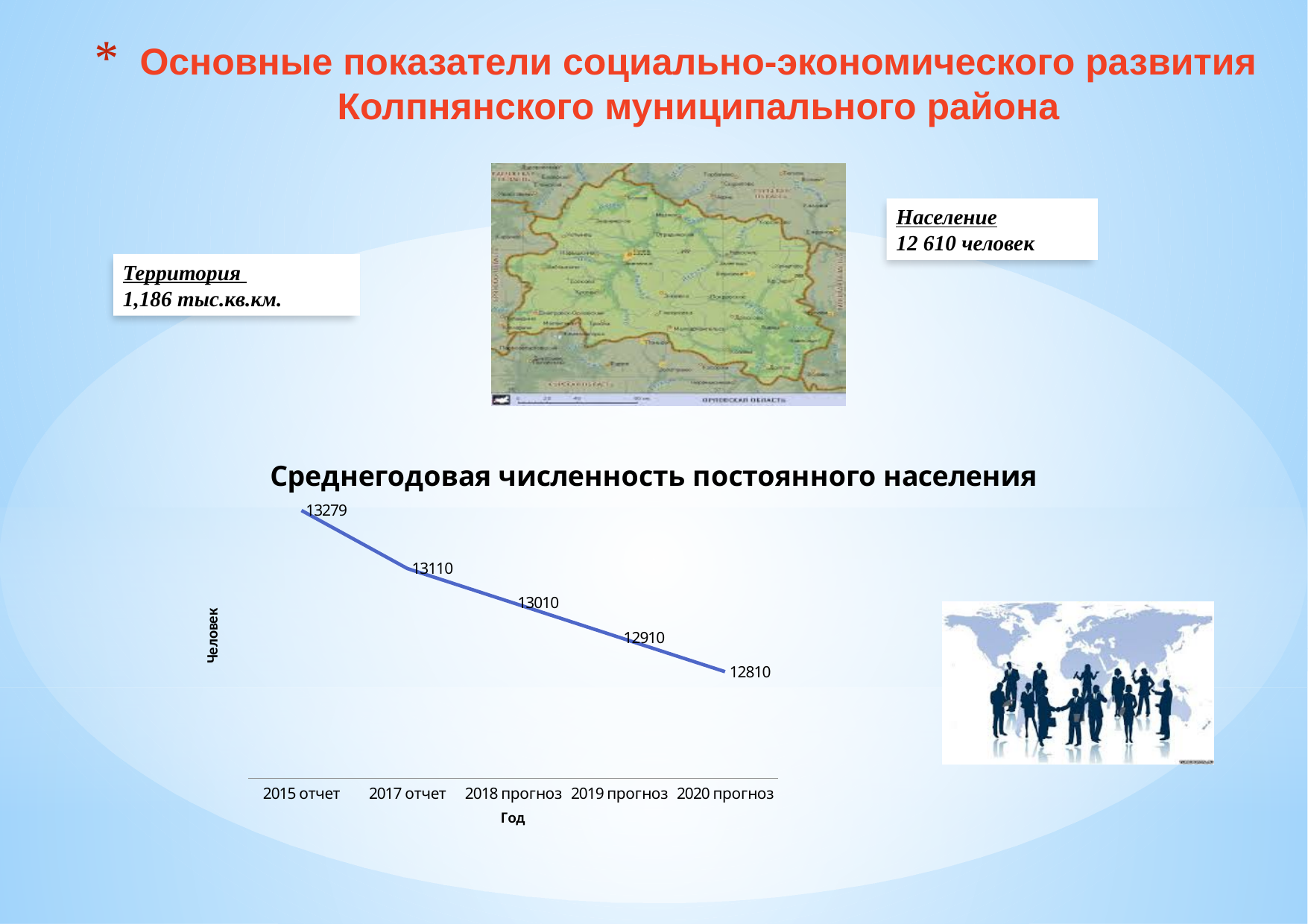
What is the value for 2018 прогноз? 13010 What is the value for 2015 отчет? 13279 Which year has the highest value? 2015 отчет What is the difference between the values for 2015 отчет and 2017 отчет? 169 What is the difference between the values for 2019 прогноз and 2020 прогноз? 100 What is the value for 2020 прогноз? 12810 How many data points are plotted on the chart? 5 Do the values rise or fall from 2015 to 2020? fall Which year has the lowest value? 2020 прогноз What is the title of the chart? Среднегодовая численность постоянного населения What kind of chart is shown? line chart Which is larger, the value for 2017 отчет or the value for 2019 прогноз? 2017 отчет